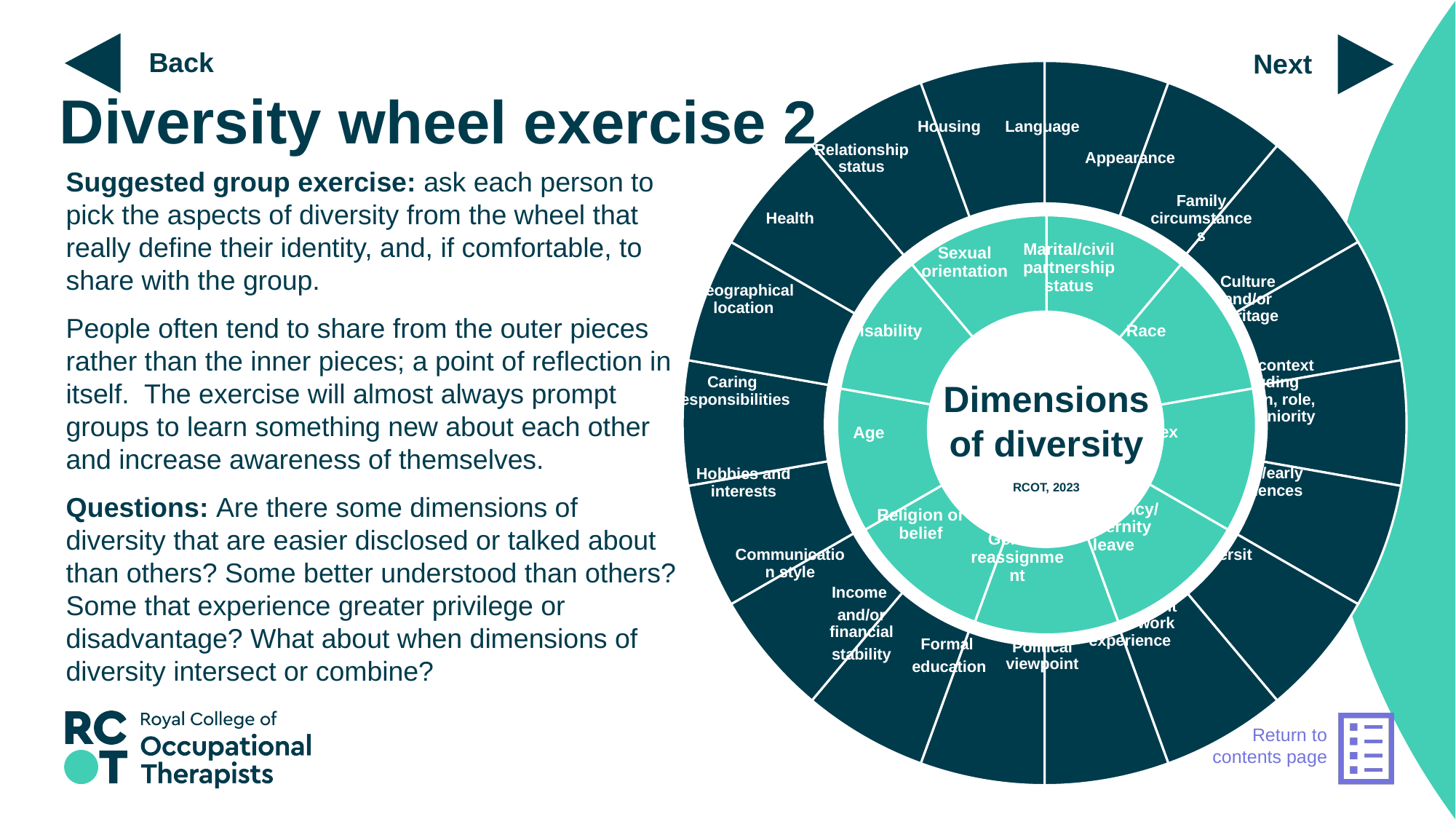
Which segment sits directly to the right of 'Housing' in the outer ring? Language What source and year are printed in the centre of the wheel? RCOT, 2023 How many segments are in the inner (light green) ring of the wheel? 9 Which ring of the wheel contains the segment labelled 'Age', the inner or the outer? Inner Which ring of the wheel contains the segment labelled 'Housing', the inner or the outer? Outer What kind of chart is the diversity wheel? A ring (doughnut-style) wheel diagram with two concentric rings of segments What is the title shown at the centre of the diversity wheel? Dimensions of diversity Which inner-ring segment is labelled next to 'Sexual orientation' at the top of the wheel? Marital/civil partnership status